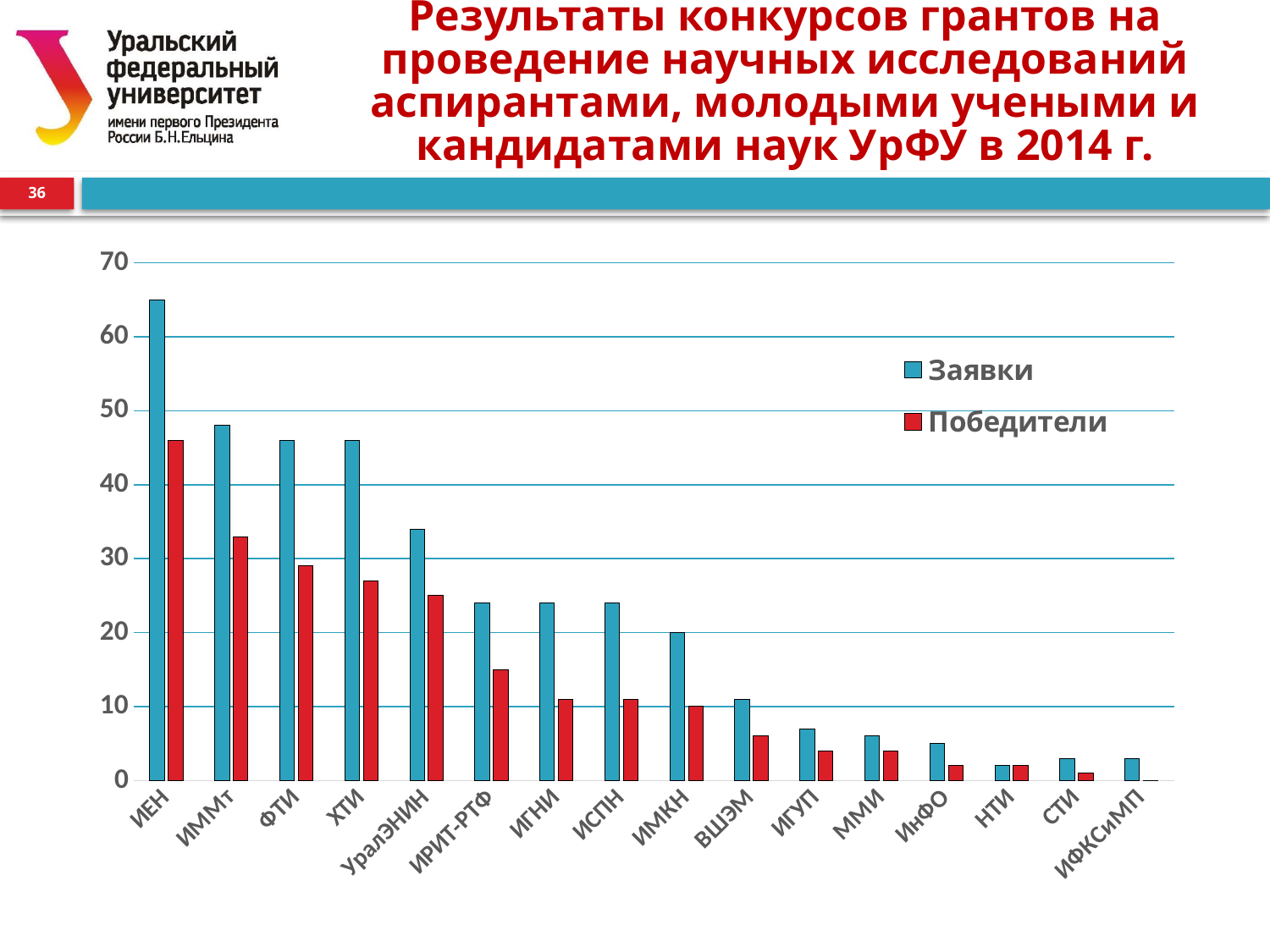
Is the value of Заявки for ИММт greater or less than 50? less Which category has the lowest value for Победители? ИФКСиМП Is the value of Заявки for УралЭНИН greater or less than 30? greater Which category has the highest value for Заявки? ИЕН Which category has the highest value for Победители? ИЕН Is the value of Победители for ИРИТ-РТФ greater or less than 10? greater Which is larger: Победители for ИРИТ-РТФ or Победители for ИГНИ? ИРИТ-РТФ Do the Заявки values generally rise or fall from left to right along the x axis? fall How many categories (institutes) are shown on the x axis? 16 How many series does the legend list? 2 What kind of chart is shown on the slide? bar chart